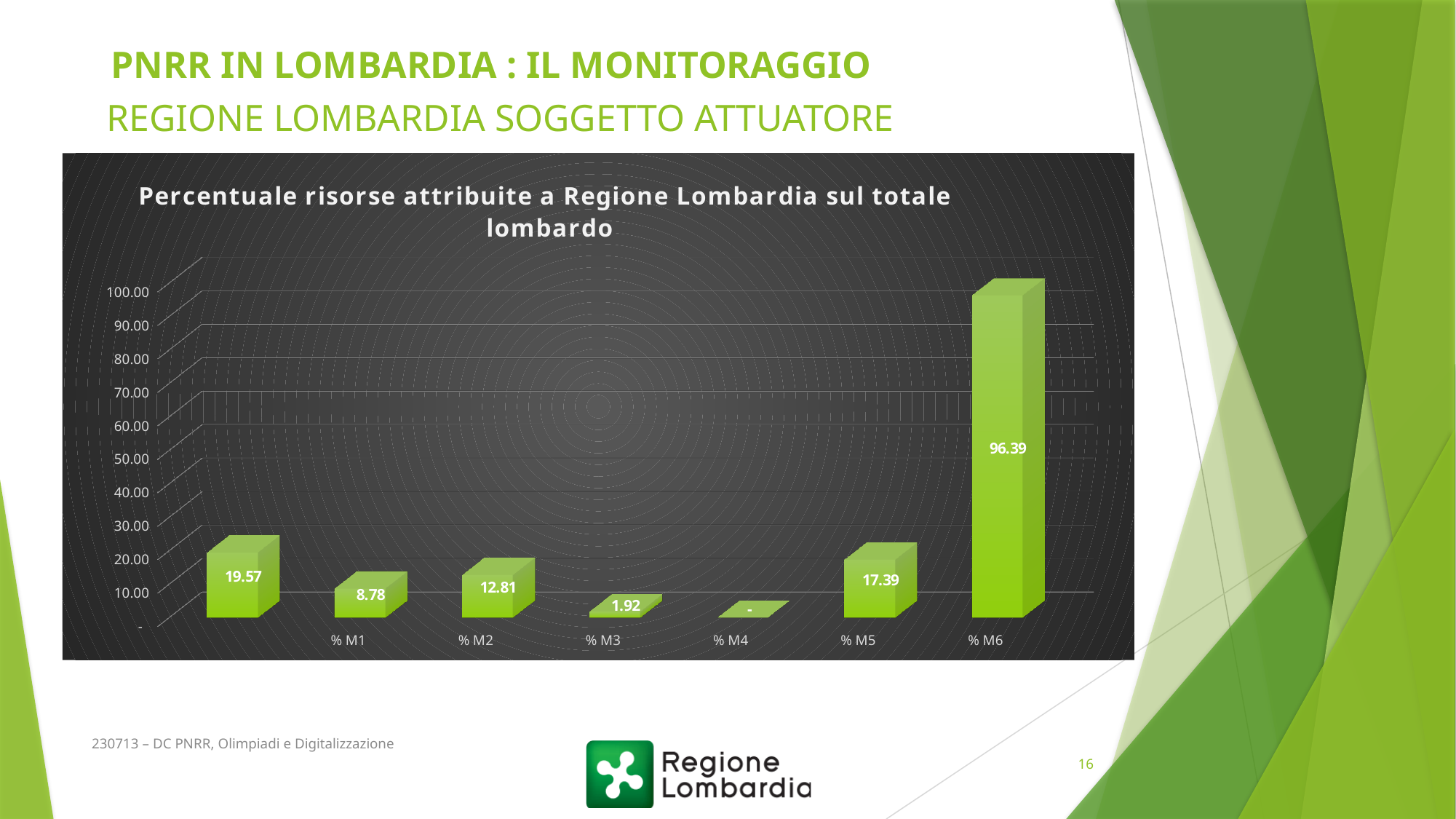
Which category has the highest value? % M6 What is the value for % M6? 96.39 What is the value for % M5? 17.39 What is the difference between the values for % M5 and % M2? 4.58 What kind of chart is shown on the slide? bar chart What is the difference between the values for % M6 and % M5? 79.00 What is the value for % M2? 12.81 Which labelled category has the lowest value? % M4 Which is larger, the value for % M1 or the value for % M2? % M2 Is the value for % M6 greater or less than 90.00? greater What is the value for % M3? 1.92 What is the value for % M1? 8.78